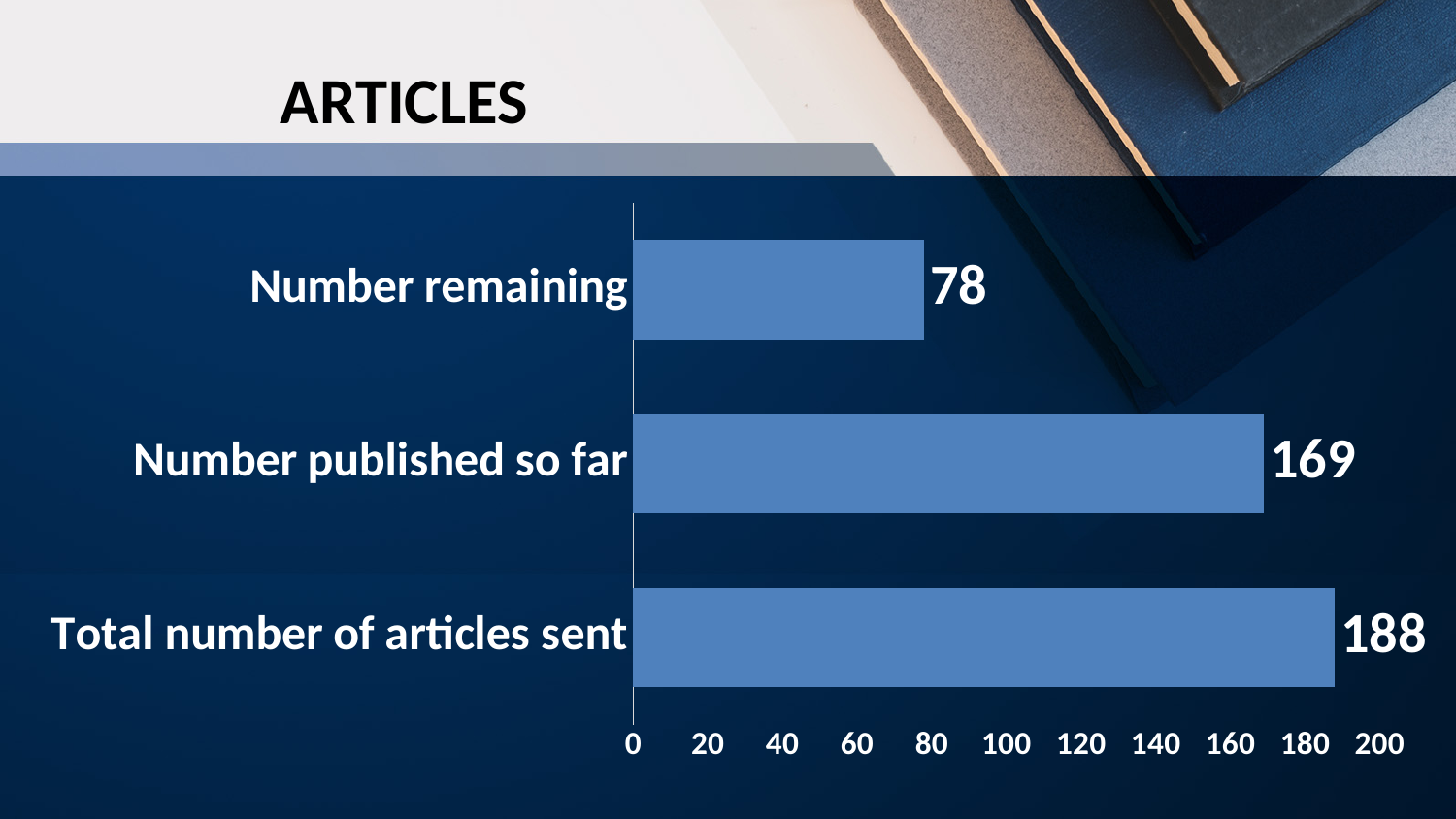
Which category has the highest value? Total number of articles sent What is the value for Number published so far? 169 What is the value for Number remaining? 78 What kind of chart is shown on the slide? bar chart Is the value for Number remaining greater or less than 100? less Which category has the lowest value? Number remaining What is the difference between Number published so far and Number remaining? 91 What is the value for Total number of articles sent? 188 How many categories are shown in the chart? 3 What is the difference between Total number of articles sent and Number published so far? 19 What is the title of the slide? ARTICLES Which is larger, Number remaining or Number published so far? Number published so far